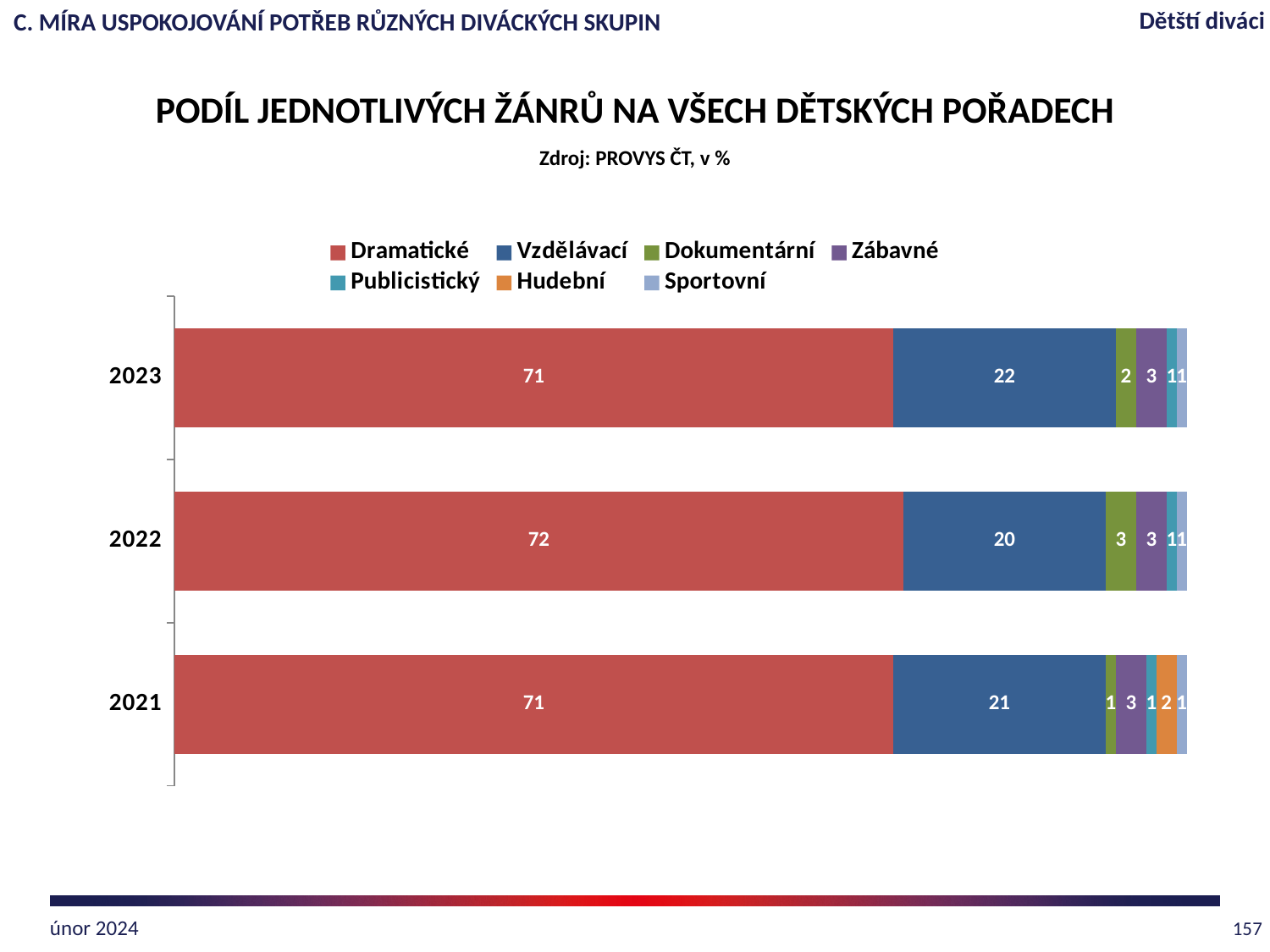
What kind of chart is shown? Stacked bar chart In which year is the Dramatické share highest? 2022 What is the value for Dokumentární in 2022? 3 What is the difference between the Vzdělávací values for 2023 and 2022? 2 How many years are shown on the chart? 3 What is the total of the stacked bar for 2021? 100 What is the value for Vzdělávací in 2023? 22 Which is larger, the Dokumentární value in 2023 or in 2022? 2022 How many series does the legend list? 7 What is the value for Dramatické in 2022? 72 In which year is the Vzdělávací share lowest? 2022 What is the value for Hudební in 2021? 2